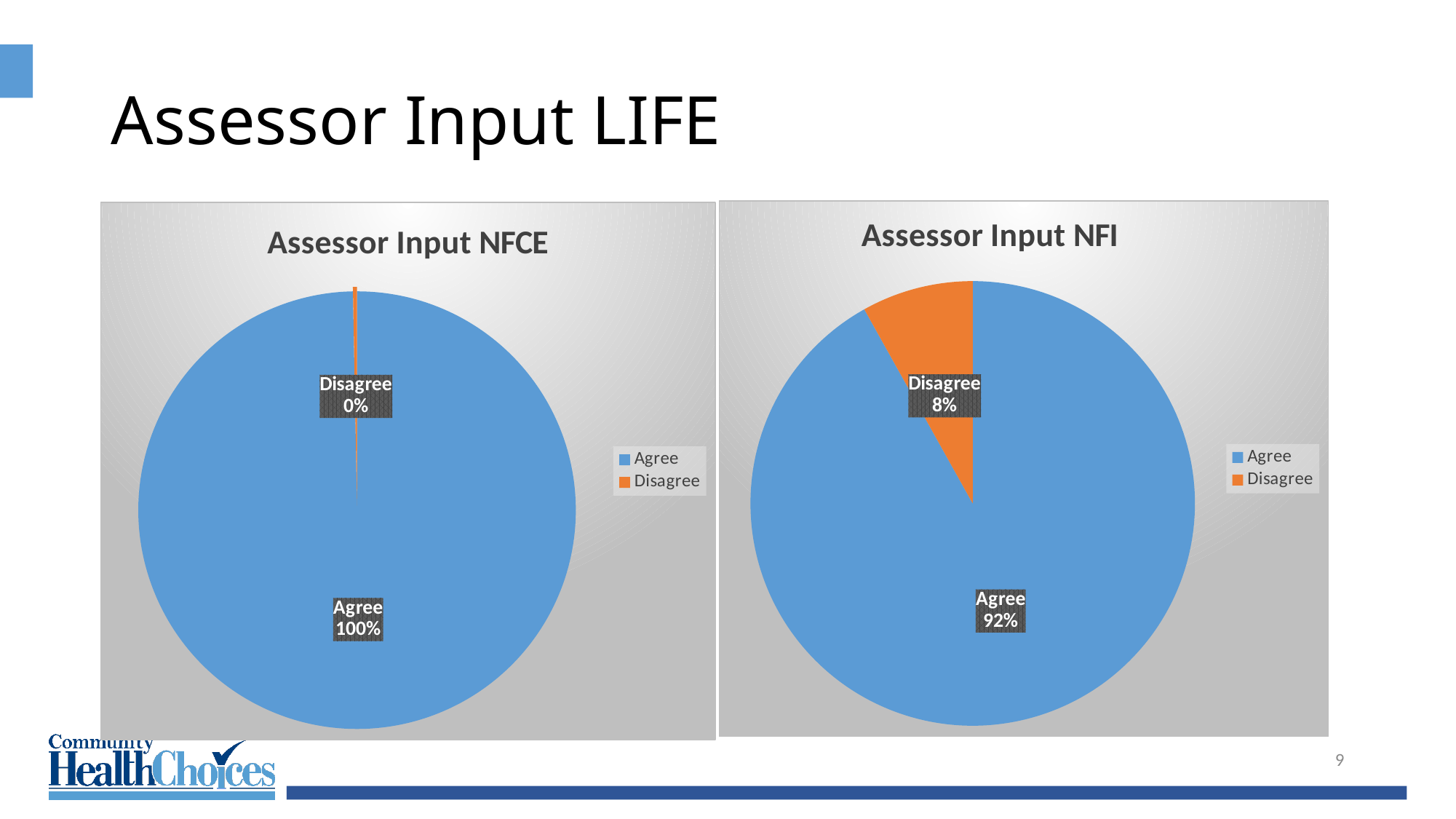
In the 'Assessor Input NFI' chart, what colour represents Disagree? Orange In the 'Assessor Input NFI' chart, which slice is the smallest? Disagree In the 'Assessor Input NFI' chart, which slice is the largest? Agree What is the title of the chart on the left side of the slide? Assessor Input NFCE In the 'Assessor Input NFCE' chart, what percentage is shown for Disagree? 0% How many categories does the legend of the 'Assessor Input NFI' chart list? 2 Which chart has the larger Disagree share, 'Assessor Input NFCE' or 'Assessor Input NFI'? Assessor Input NFI In the 'Assessor Input NFI' chart, what percentage is shown for Agree? 92% What type of chart is 'Assessor Input NFCE'? Pie chart In the 'Assessor Input NFI' chart, what percentage is shown for Disagree? 8% In the 'Assessor Input NFCE' chart, what percentage is shown for Agree? 100% In the 'Assessor Input NFI' chart, what is the difference between the Agree and Disagree percentages? 84%